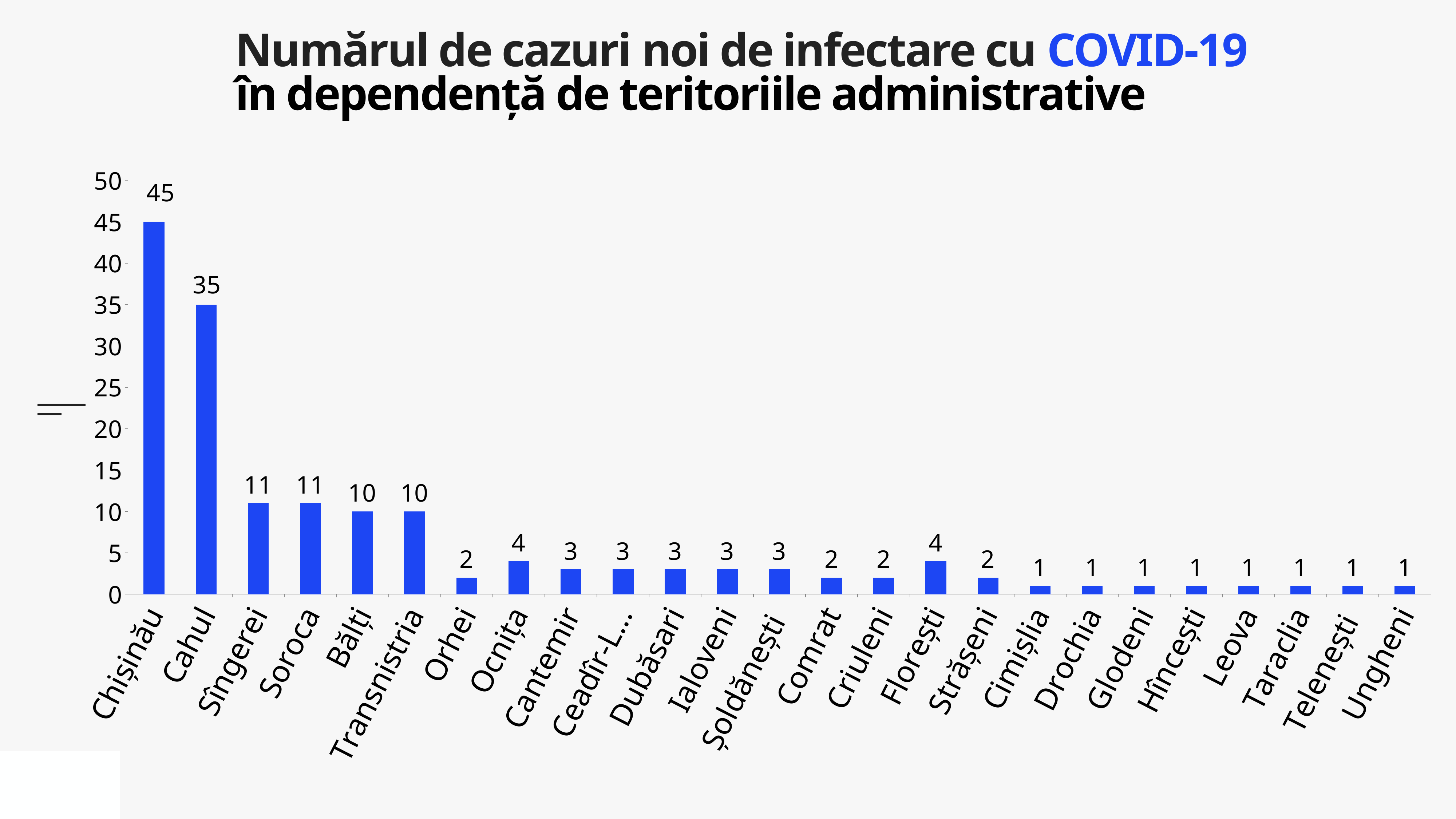
What is the difference between the values for Chișinău and Cahul? 10 Which is larger, the value for Ocnița or the value for Comrat? Ocnița What is the value for Ungheni? 1 What is the value for Bălți? 10 What is the value for Florești? 4 Is the value for Cahul greater or less than 30? greater What is the value for Chișinău? 45 What is the value for Cahul? 35 What kind of chart is shown on the slide? bar chart What is the difference between the values for Sîngerei and Orhei? 9 How many categories are shown on the x axis? 25 Which category has the highest value? Chișinău